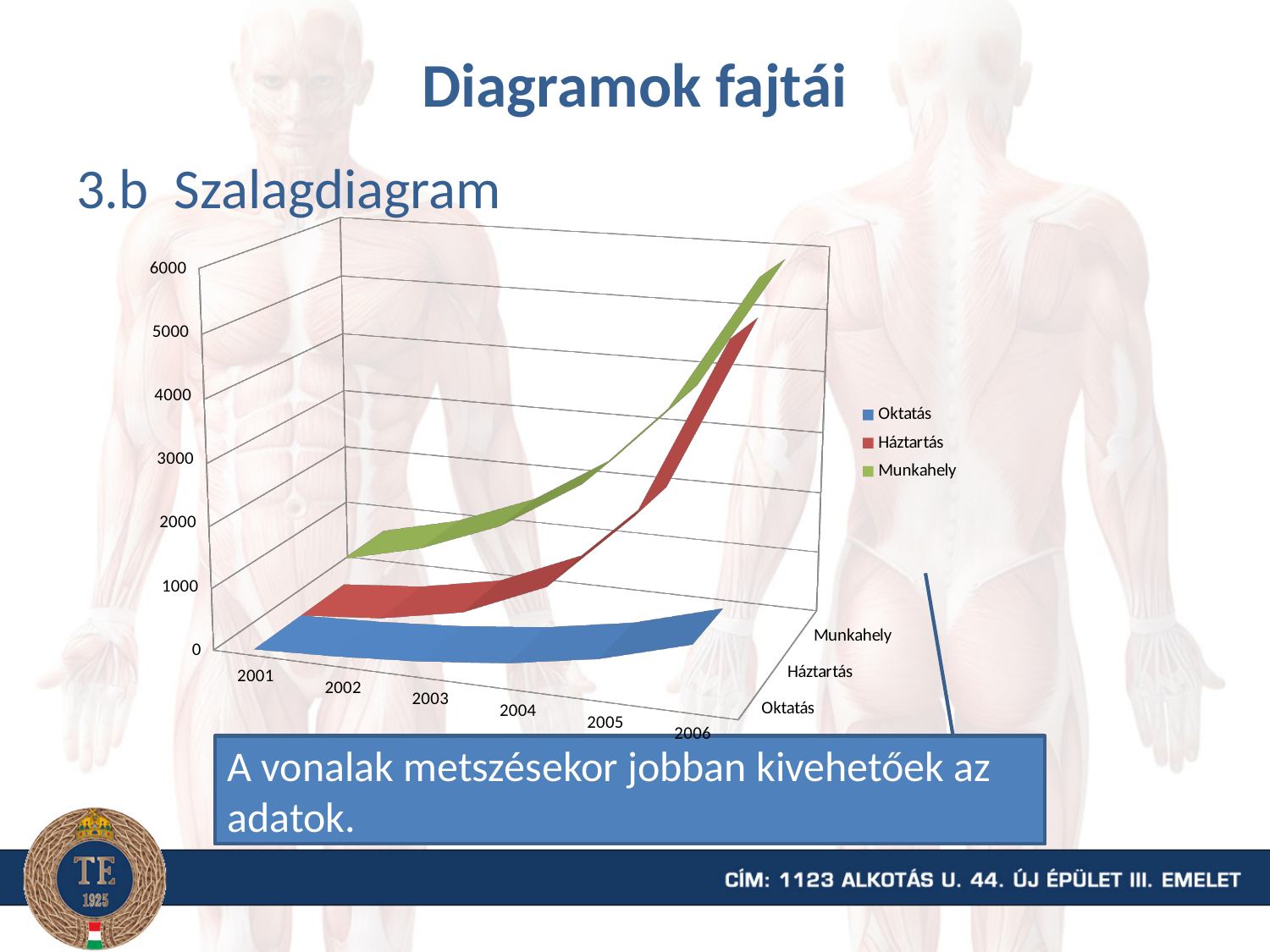
Do the values for Munkahely rise or fall from 2001 to 2006? rise Which series is shown in blue in the chart? Oktatás What kind of chart is shown on the slide? ribbon chart Which series has the highest value in 2006? Munkahely Which series has the lowest value in 2006? Oktatás What is the first year shown on the x axis of the chart? 2001 Do the values for Háztartás rise or fall from 2001 to 2006? rise Which series is shown in green in the chart? Munkahely In 2006, which is larger: the value for Munkahely or the value for Oktatás? Munkahely How many years are shown along the x axis of the chart? 6 How many series does the chart's legend list? 3 In 2006, which is larger: the value for Háztartás or the value for Oktatás? Háztartás